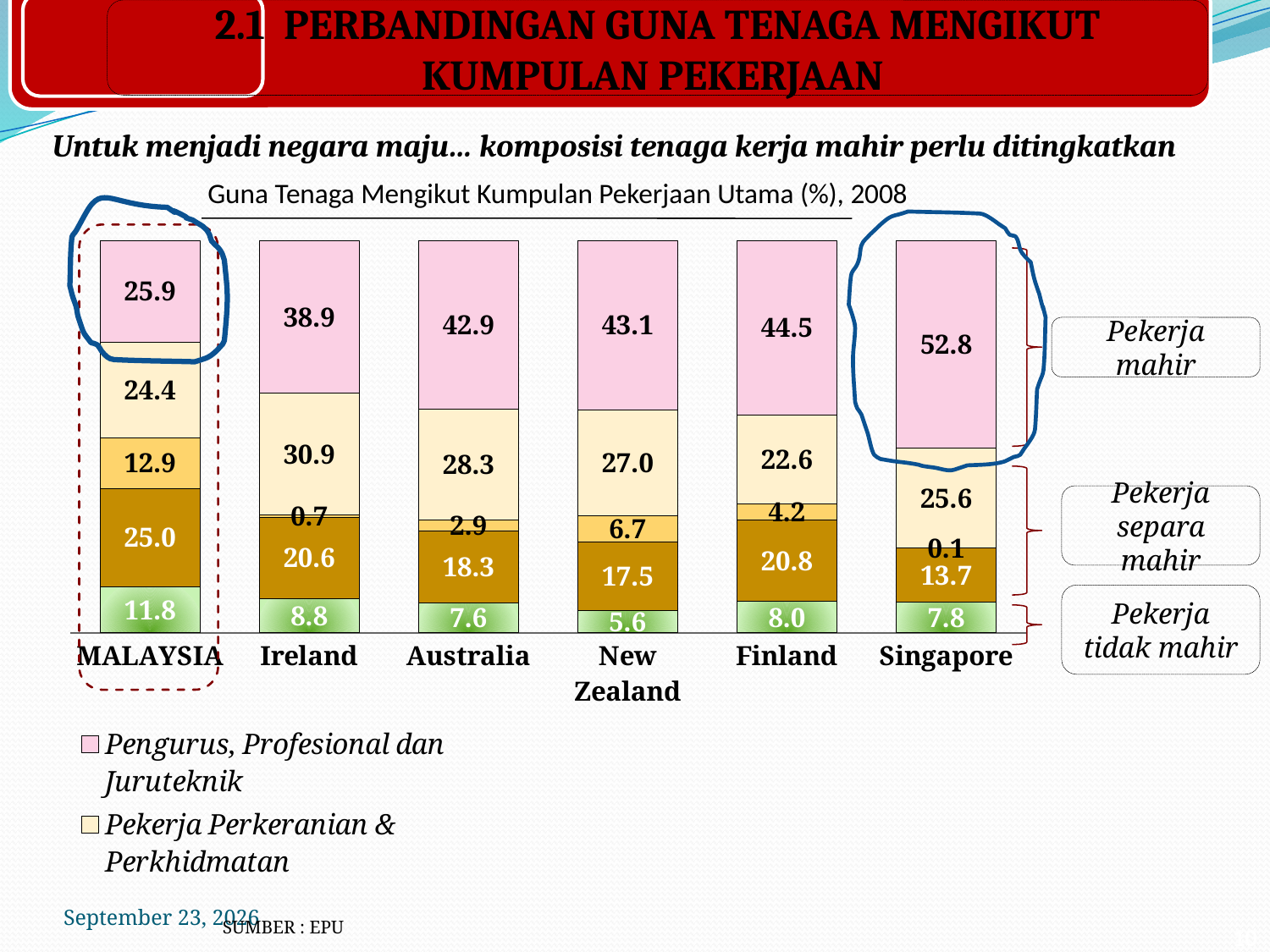
Which country has the highest value for Pengurus, Profesional dan Juruteknik? Singapore What is the value of Pengurus, Profesional dan Juruteknik for Singapore? 52.8 What is the difference between Singapore's and MALAYSIA's values for Pengurus, Profesional dan Juruteknik? 26.9 How many countries are shown on the chart? 6 Which country has the lowest value in the bottom segment of its bar? New Zealand What is the value of Pekerja Perkeranian & Perkhidmatan for Ireland? 30.9 Do the values for Pengurus, Profesional dan Juruteknik rise or fall from MALAYSIA to Singapore along the x axis? Rise What is the value of the bottom segment of the MALAYSIA bar? 11.8 What is the title of the chart? Guna Tenaga Mengikut Kumpulan Pekerjaan Utama (%), 2008 Which is larger for Pekerja Perkeranian & Perkhidmatan: MALAYSIA or Australia? Australia What kind of chart is shown on the slide? Stacked bar chart Which country has the lowest value for Pengurus, Profesional dan Juruteknik? MALAYSIA